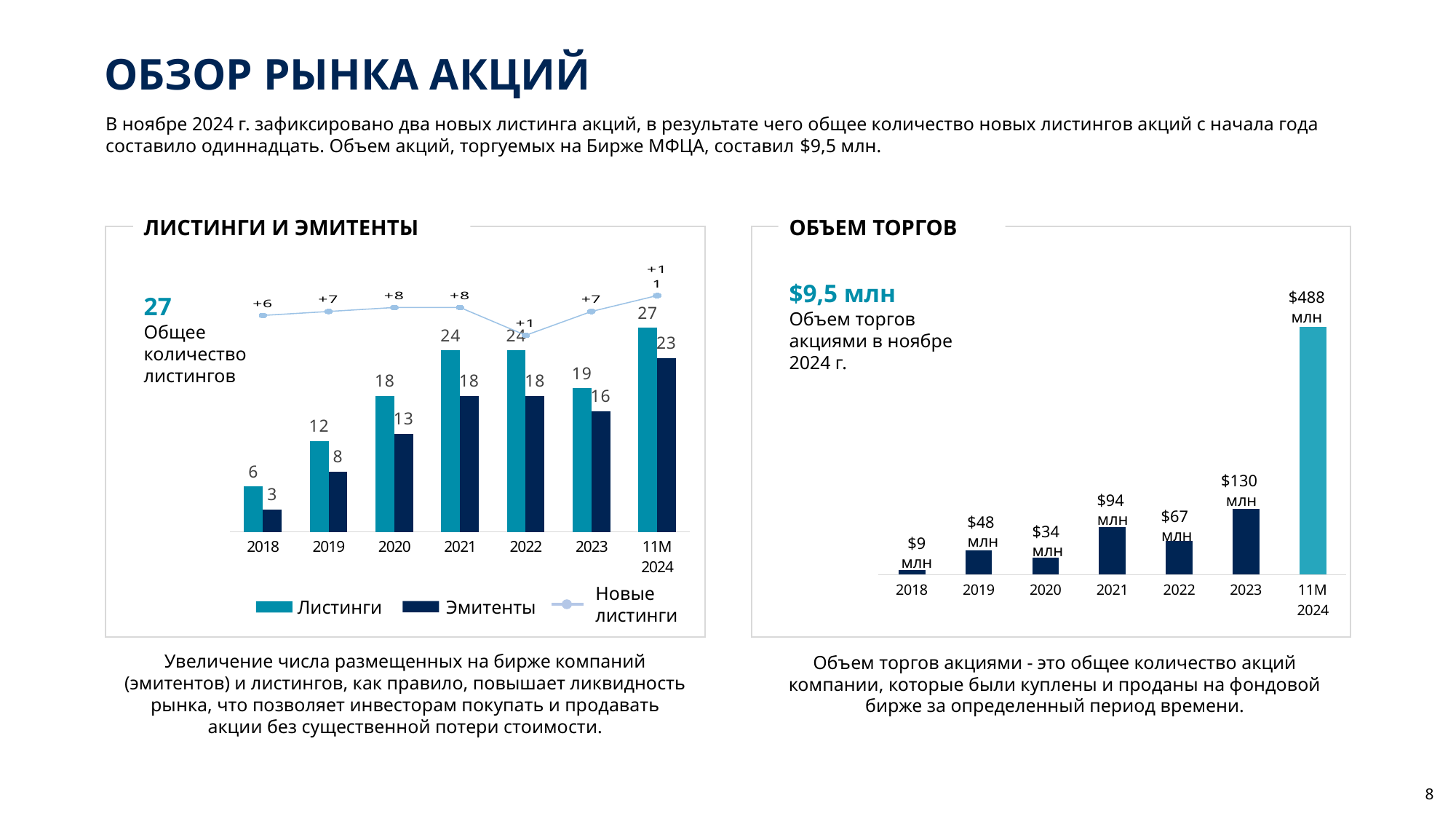
In the 'ЛИСТИНГИ И ЭМИТЕНТЫ' chart, what is the value of Новые листинги for 2022? +1 In the 'ЛИСТИНГИ И ЭМИТЕНТЫ' chart, what is the difference between Листинги and Эмитенты in 2019? 4 In the 'ЛИСТИНГИ И ЭМИТЕНТЫ' chart, which period has the highest value of Листинги? 11M 2024 In the 'ЛИСТИНГИ И ЭМИТЕНТЫ' chart, what is the value of Эмитенты for 2023? 16 In the 'ОБЪЕМ ТОРГОВ' chart, which year has the lowest value? 2018 In the 'ОБЪЕМ ТОРГОВ' chart, which period has the highest value? 11M 2024 In the 'ЛИСТИНГИ И ЭМИТЕНТЫ' chart, how many series does the legend list? 3 In the 'ЛИСТИНГИ И ЭМИТЕНТЫ' chart, what is the value of Листинги for 2020? 18 In the 'ЛИСТИНГИ И ЭМИТЕНТЫ' chart, which year has the lowest value of Эмитенты? 2018 In the 'ОБЪЕМ ТОРГОВ' chart, how many periods are shown on the x axis? 7 In the 'ОБЪЕМ ТОРГОВ' chart, what is the value for 2021? $94 млн In the 'ОБЪЕМ ТОРГОВ' chart, which is larger: the value for 2020 or the value for 2022? 2022